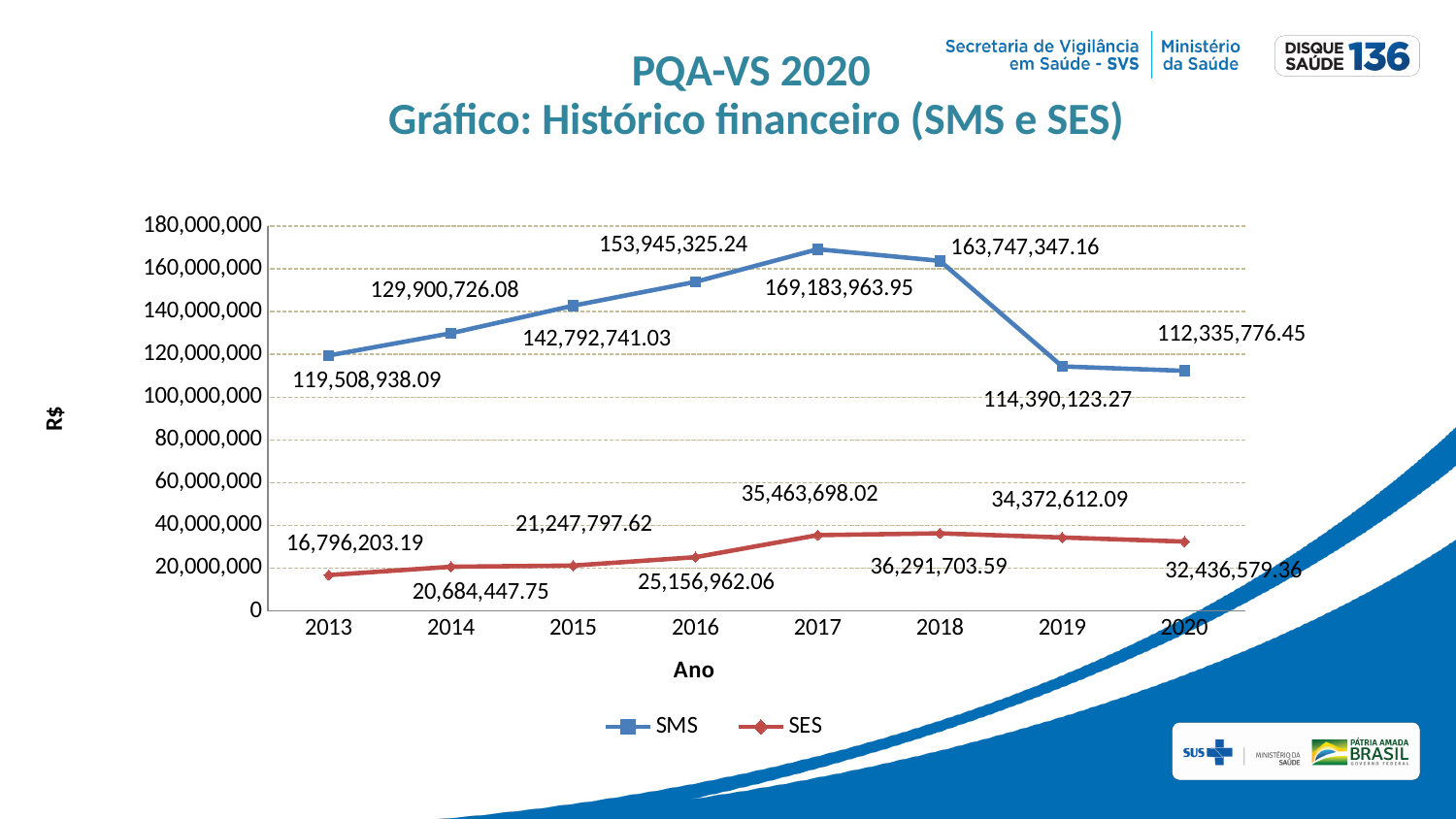
What is the SMS value for 2017? 169,183,963.95 What is the difference between the SMS values for 2018 and 2019? 49,357,223.89 Which is larger, the SES value for 2017 or for 2018? 2018 In which year is the SMS value highest? 2017 How many series does the legend list? 2 How many years are shown on the x axis? 8 What kind of chart is shown on the slide? Line chart What is the SES value for 2020? 32,436,579.36 Does the SMS series rise or fall from 2013 to 2017? Rise In which year is the SES value lowest? 2013 In which year is the SMS value lowest? 2020 What is the SES value for 2014? 20,684,447.75